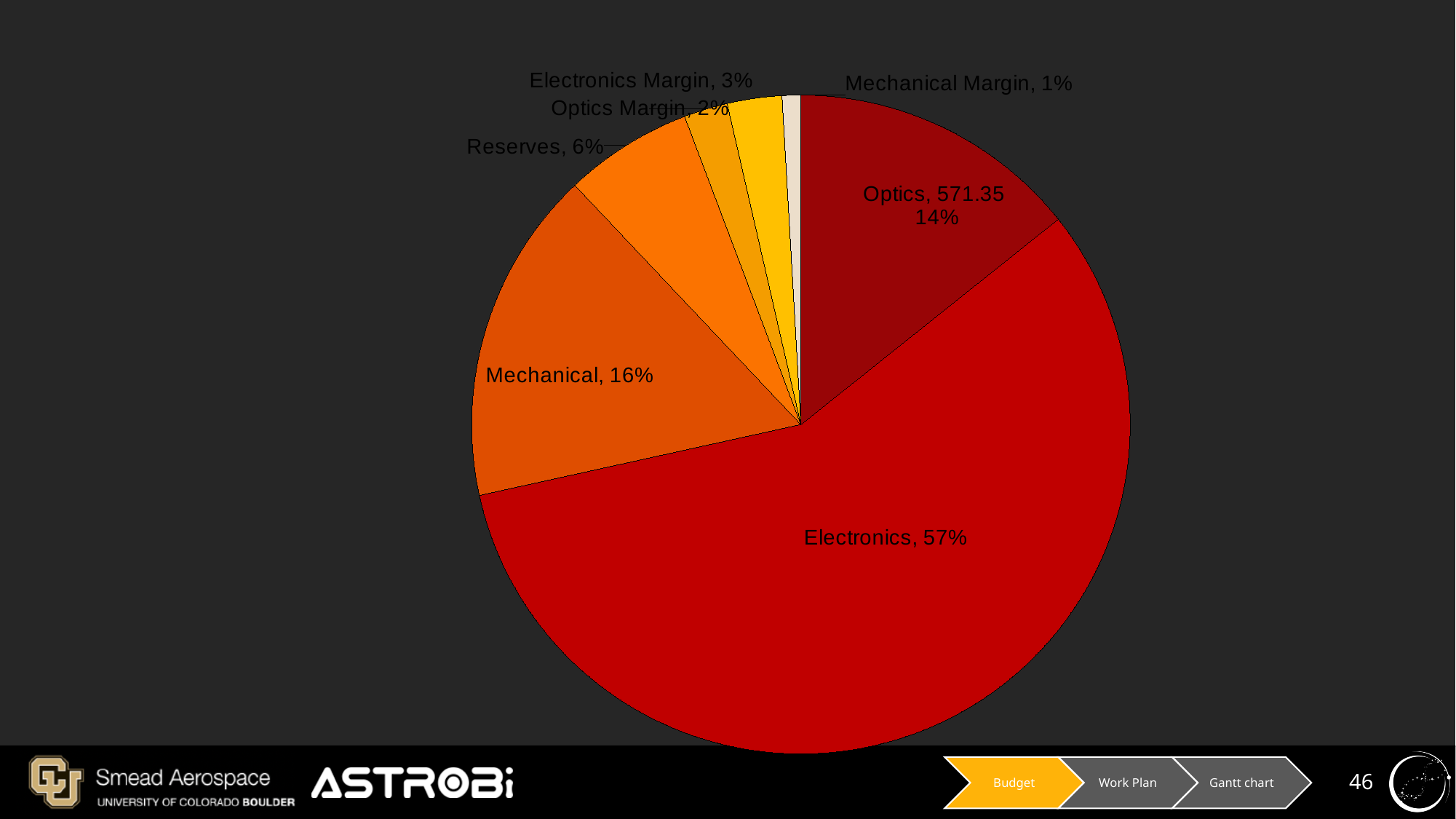
What share of the pie does Reserves take? 6% Which slice is the largest? Electronics What value is printed for the Optics slice? 571.35 What share of the pie does Mechanical take? 16% Which is larger, the Optics Margin share or the Electronics Margin share? Electronics Margin What share of the pie does Electronics take? 57% What kind of chart is shown on the slide? pie chart What is the difference in percentage points between the Electronics and Mechanical shares? 41 Which slice is the smallest? Mechanical Margin How many slices does the pie chart have? 7